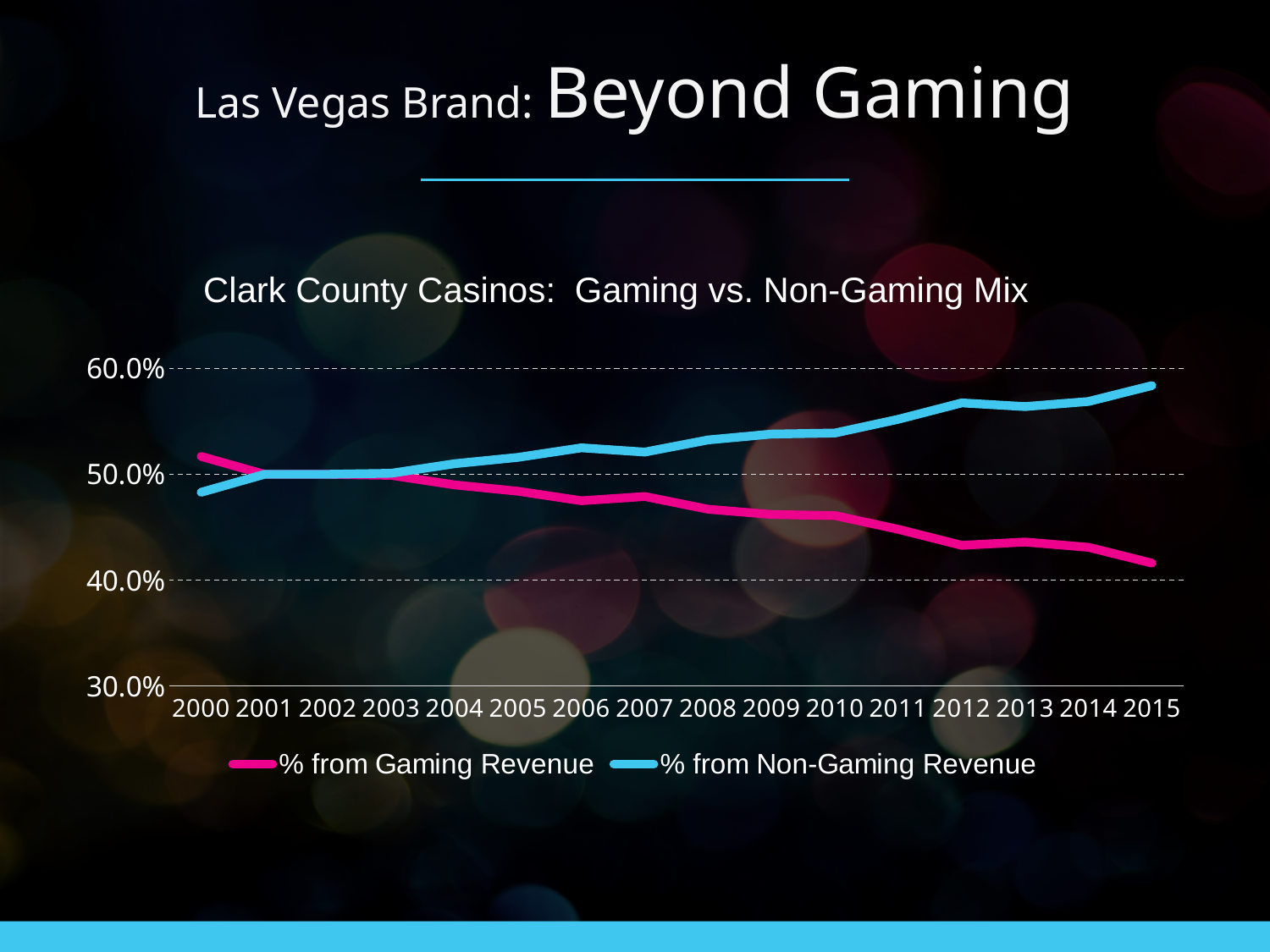
In which year is % from Non-Gaming Revenue highest? 2015 What kind of chart is shown on the slide? line chart How many series does the legend list? 2 In 2015, which series has the larger value, % from Gaming Revenue or % from Non-Gaming Revenue? % from Non-Gaming Revenue Is the value for % from Non-Gaming Revenue in 2015 greater or less than 60.0%? less Does the % from Non-Gaming Revenue line rise or fall from 2000 to 2015? rise What is the title of the chart? Clark County Casinos: Gaming vs. Non-Gaming Mix Is the value for % from Gaming Revenue in 2015 greater or less than 40.0%? greater How many years are shown along the x axis? 16 In which year is % from Gaming Revenue lowest? 2015 Does the % from Gaming Revenue line rise or fall from 2000 to 2015? fall Is the value for % from Non-Gaming Revenue in 2000 greater or less than 50.0%? less